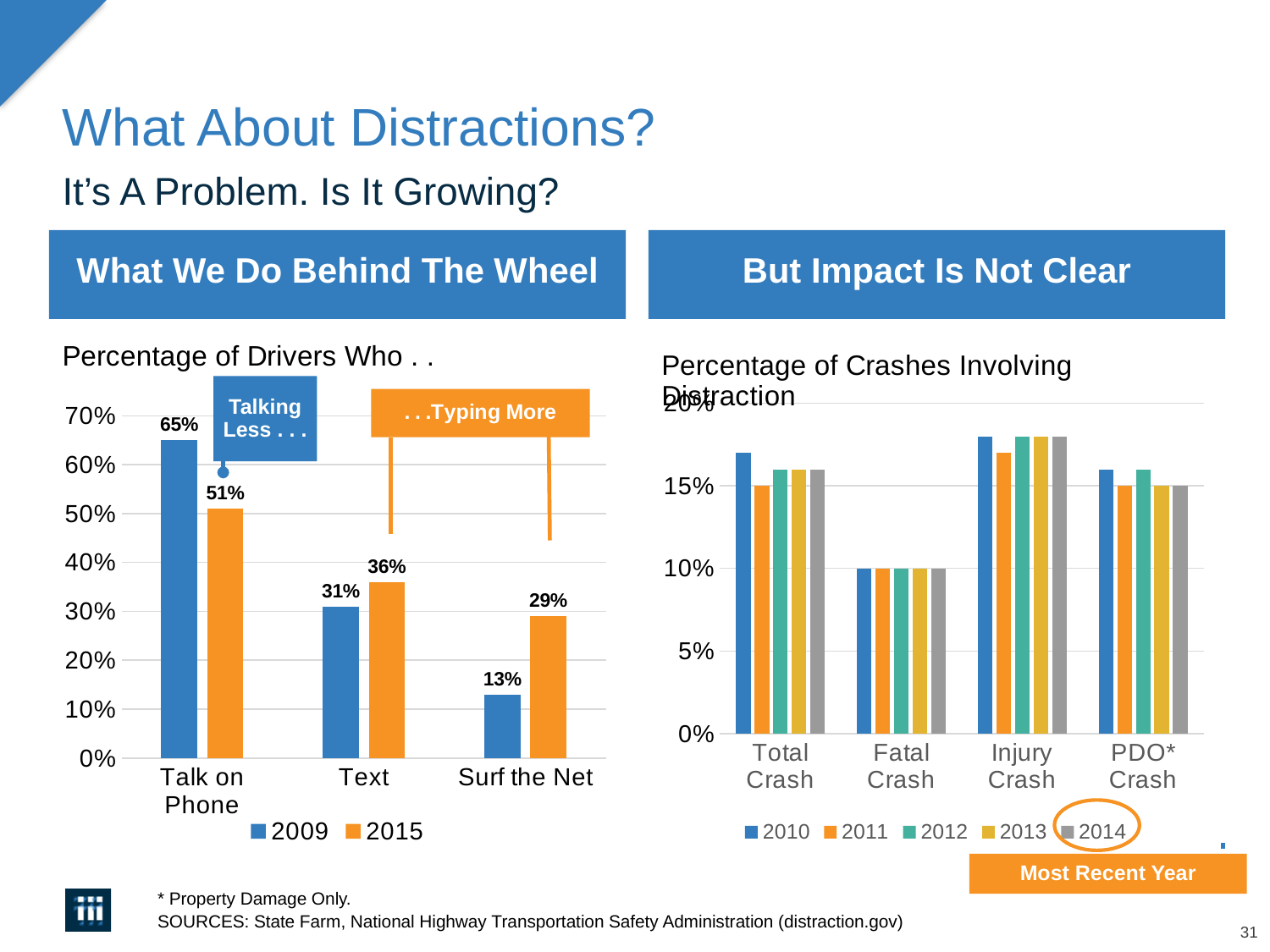
On the left chart (Percentage of Drivers Who . .), which is larger for Text: the 2009 value or the 2015 value? 2015 On the left chart (Percentage of Drivers Who . .), what is the 2015 value for Surf the Net? 29% On the left chart (Percentage of Drivers Who . .), by how many percentage points did Talk on Phone fall from 2009 to 2015? 14 percentage points On the right chart (Percentage of Crashes Involving Distraction), how many years does the legend list? 5 On the left chart (Percentage of Drivers Who . .), how many series does the legend list? 2 On the left chart (Percentage of Drivers Who . .), what is the 2015 value for Text? 36% On the left chart (Percentage of Drivers Who . .), which category has the highest value in 2015? Talk on Phone On the left chart (Percentage of Drivers Who . .), what percentage of drivers talked on the phone in 2009? 65% On the right chart (Percentage of Crashes Involving Distraction), is the 2010 value for Injury Crash greater or less than 15%? greater What kind of chart is the right chart (Percentage of Crashes Involving Distraction)? Bar chart On the right chart (Percentage of Crashes Involving Distraction), how many crash categories are shown on the x axis? 4 On the left chart (Percentage of Drivers Who . .), which category has the lowest value in 2009? Surf the Net